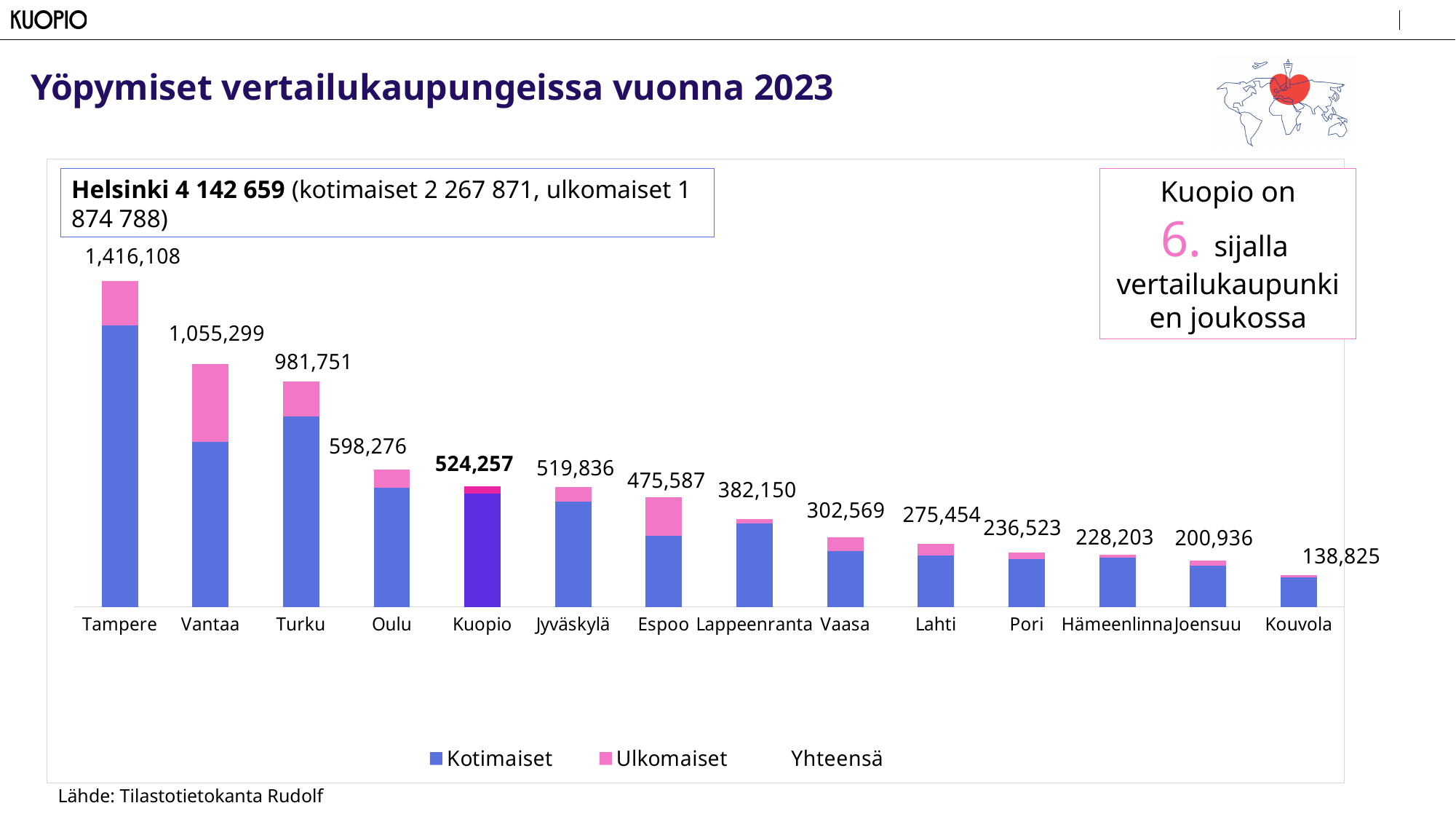
How many cities are shown as bars in the chart? 14 Which has a larger total, Turku or Espoo? Turku Which city in the chart has the lowest total? Kouvola What is the total number of overnight stays (Yhteensä) shown for Tampere? 1,416,108 What is the difference between the totals for Oulu and Kuopio? 74,019 What is the total value labelled for Kuopio? 524,257 What is the difference between the totals for Tampere and Vantaa? 360,809 How many entries does the chart legend list? 3 What is the total value labelled for Lappeenranta? 382,150 Which city in the chart has the highest total? Tampere Do the totals rise or fall from left to right along the x axis? fall What is the total value labelled for Kouvola? 138,825